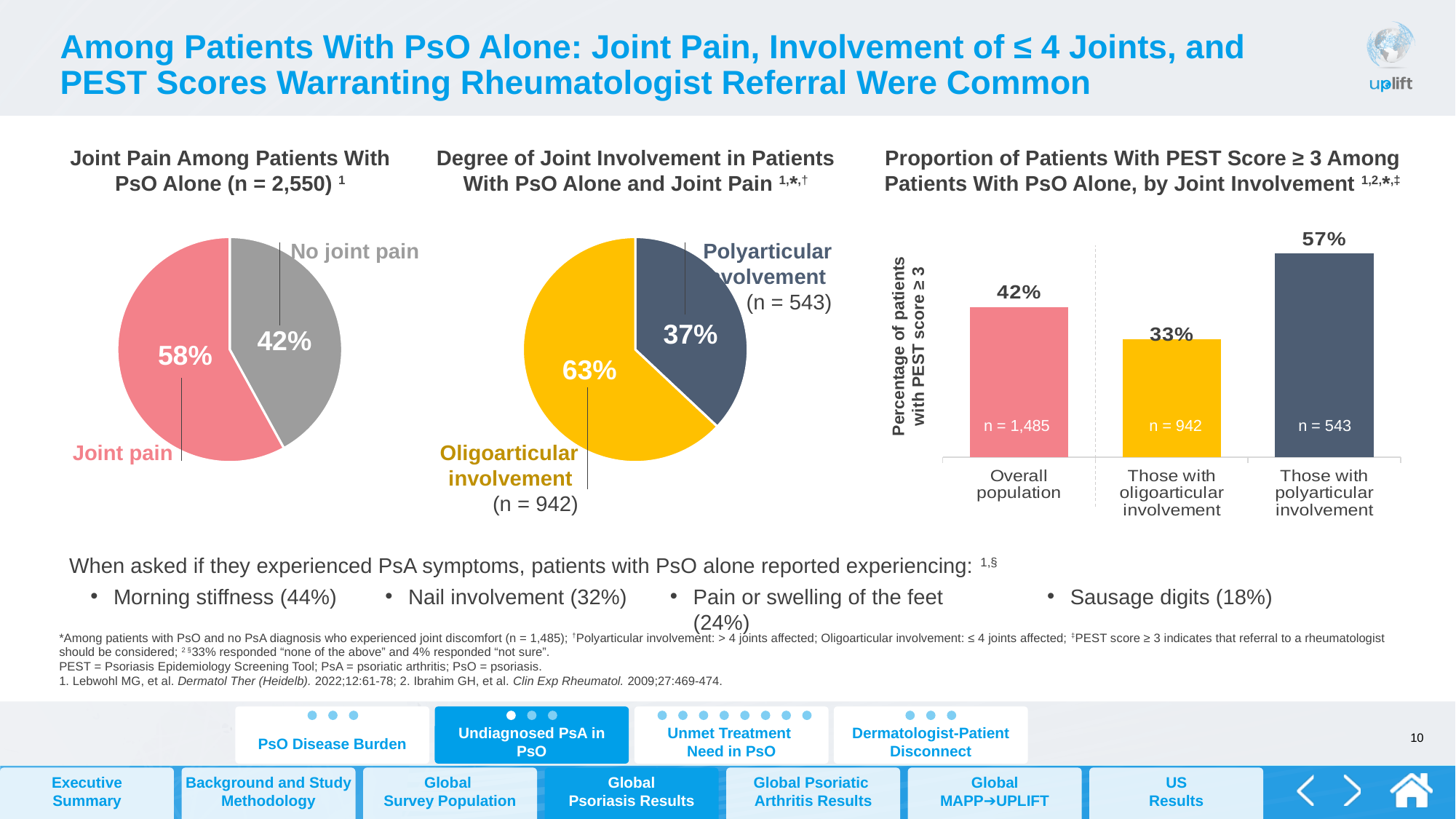
In the 'Degree of Joint Involvement' pie chart, how many patients are in the polyarticular involvement group? n = 543 In the 'Proportion of Patients With PEST Score ≥ 3' bar chart, what is the difference between the polyarticular involvement value and the oligoarticular involvement value? 24% In the 'Joint Pain Among Patients With PsO Alone' pie chart, what percentage of patients reported joint pain? 58% In the 'Degree of Joint Involvement' pie chart, which slice is larger: oligoarticular involvement or polyarticular involvement? Oligoarticular involvement In the 'Proportion of Patients With PEST Score ≥ 3' bar chart, which category has the highest value? Those with polyarticular involvement In the 'Degree of Joint Involvement' pie chart, what share of patients had polyarticular involvement? 37% How many bars are shown in the 'Proportion of Patients With PEST Score ≥ 3' bar chart? 3 In the 'Joint Pain Among Patients With PsO Alone' pie chart, what percentage of patients reported no joint pain? 42% In the 'Proportion of Patients With PEST Score ≥ 3' bar chart, what is the value for the overall population? 42% In the 'Proportion of Patients With PEST Score ≥ 3' bar chart, which category has the lowest value? Those with oligoarticular involvement What kind of chart is the 'Joint Pain Among Patients With PsO Alone' chart? Pie chart In the 'Degree of Joint Involvement' pie chart, what share of patients had oligoarticular involvement? 63%